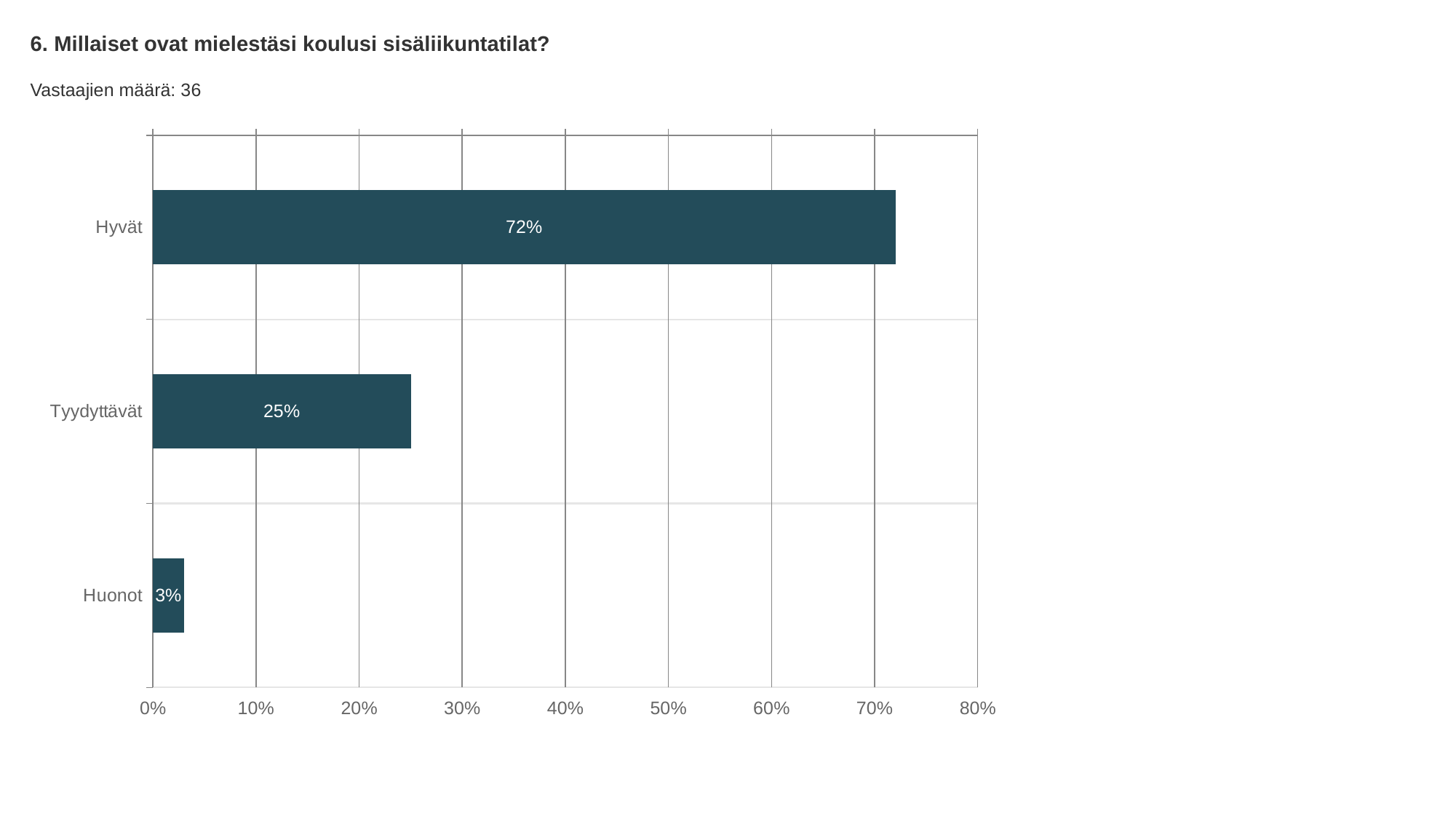
How many respondents (Vastaajien määrä) does the slide report? 36 What is the value for Hyvät? 72% Which category has the lowest value? Huonot What is the difference between the values for Tyydyttävät and Huonot? 22% What is the difference between the values for Hyvät and Tyydyttävät? 47% What is the value for Tyydyttävät? 25% What kind of chart is shown on the slide? bar chart What is the value for Huonot? 3% Is the value for Hyvät greater or less than 70%? greater Which category has the highest value? Hyvät Which is larger, the value for Tyydyttävät or the value for Huonot? Tyydyttävät How many categories are shown in the chart? 3